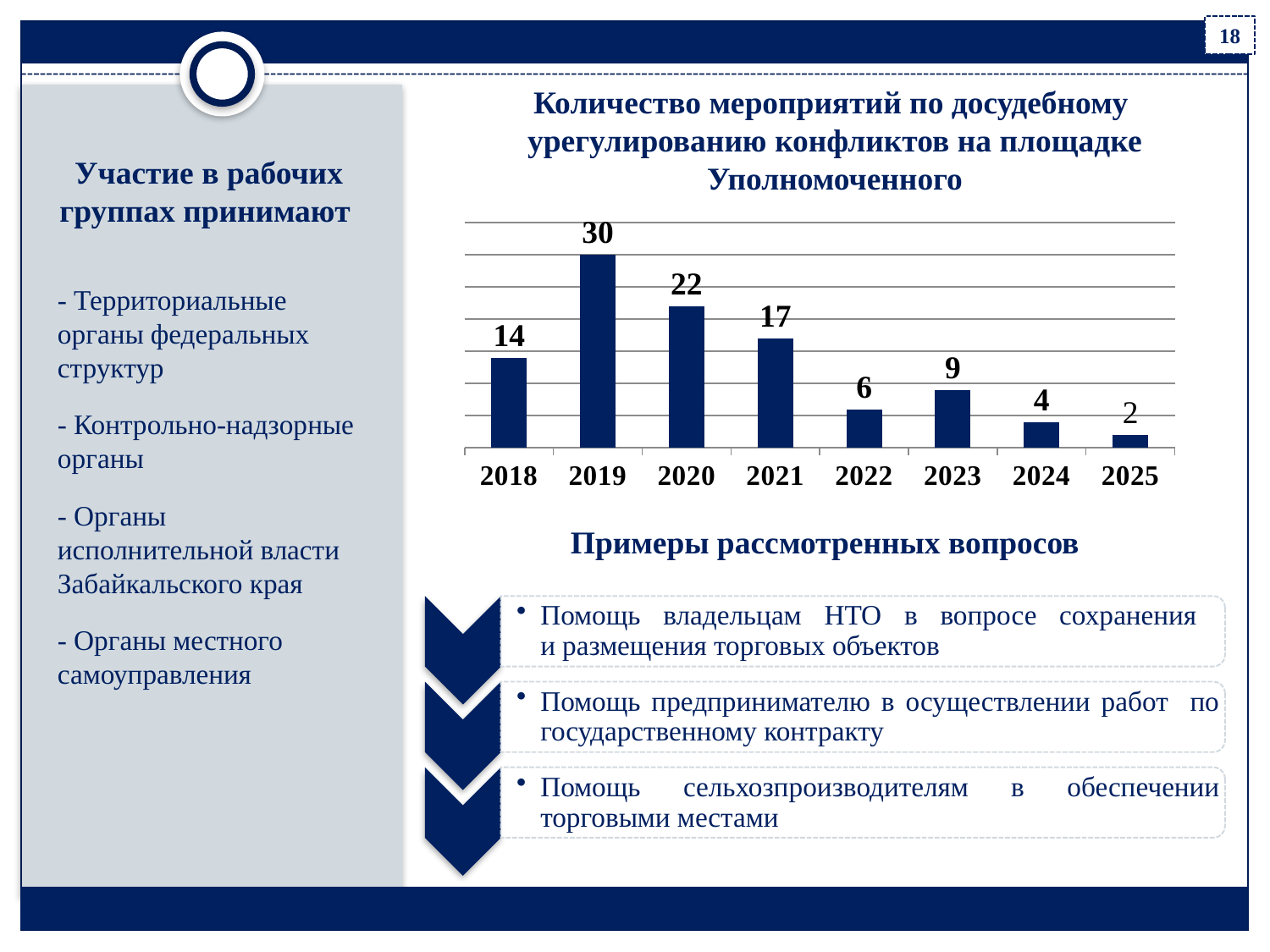
What kind of chart is shown? bar chart What is the difference between the values for 2018 and 2024? 10 Which year has the highest value? 2019 What is the value for 2025? 2 Do the values rise or fall from 2019 to 2025? fall What is the value for 2019? 30 What is the value for 2022? 6 Which year has the lowest value? 2025 How many years are shown on the x axis? 8 What is the title of the chart? Количество мероприятий по досудебному урегулированию конфликтов на площадке Уполномоченного Which is larger, the value for 2021 or the value for 2023? 2021 What is the difference between the values for 2019 and 2020? 8